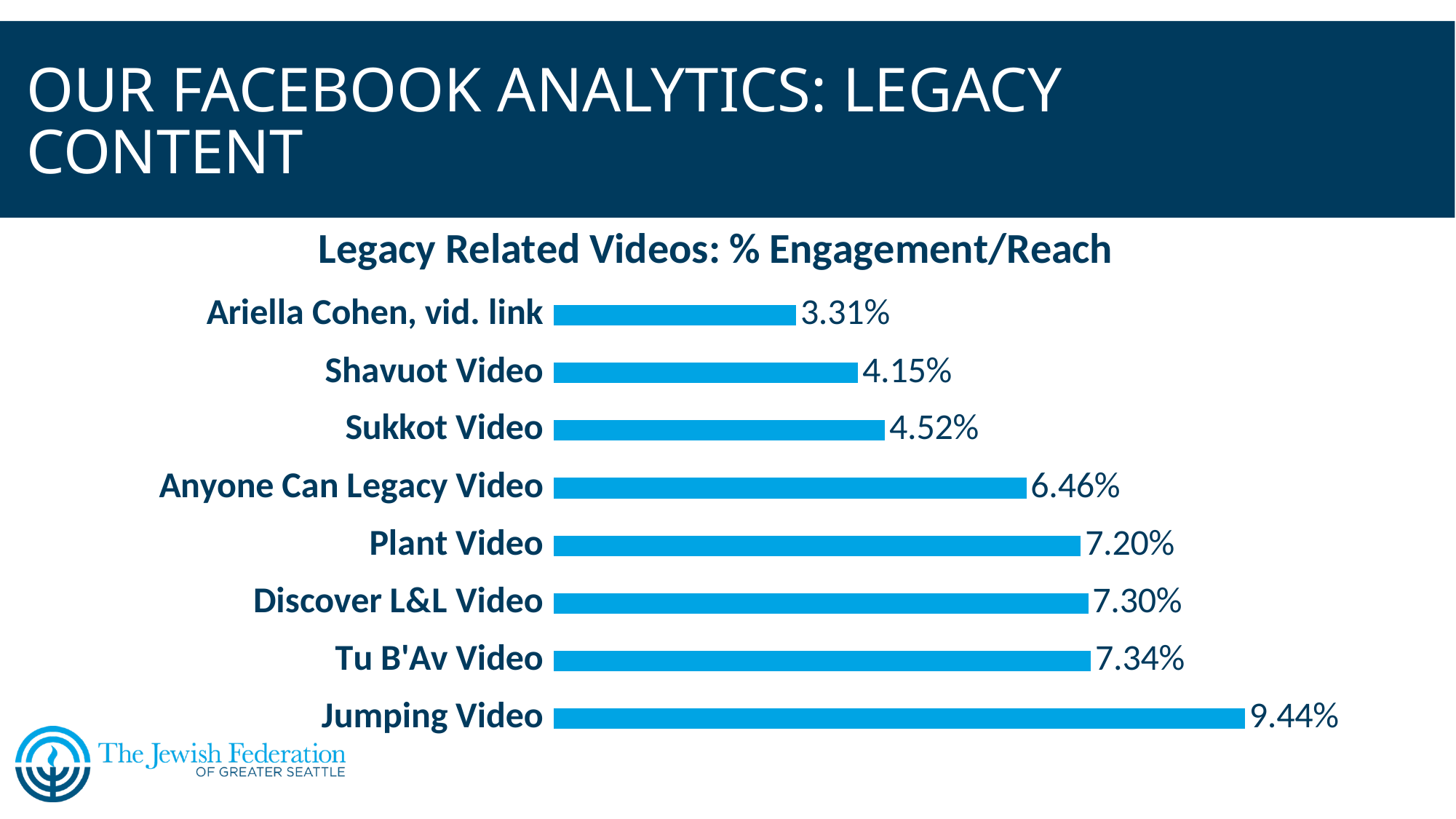
What is the % Engagement/Reach value for the Jumping Video? 9.44% What type of chart is shown on the slide? Bar chart Which has a higher % Engagement/Reach, the Anyone Can Legacy Video or the Shavuot Video? Anyone Can Legacy Video What is the title of the chart? Legacy Related Videos: % Engagement/Reach What is the % Engagement/Reach value for the Sukkot Video? 4.52% Which video has the highest % Engagement/Reach? Jumping Video What is the % Engagement/Reach value for Ariella Cohen, vid. link? 3.31% What is the % Engagement/Reach value for the Anyone Can Legacy Video? 6.46% What is the difference in % Engagement/Reach between the Jumping Video and the Shavuot Video? 5.29% What is the difference in % Engagement/Reach between the Plant Video and the Sukkot Video? 2.68% Which video has the lowest % Engagement/Reach? Ariella Cohen, vid. link How many videos are shown in the chart? 8